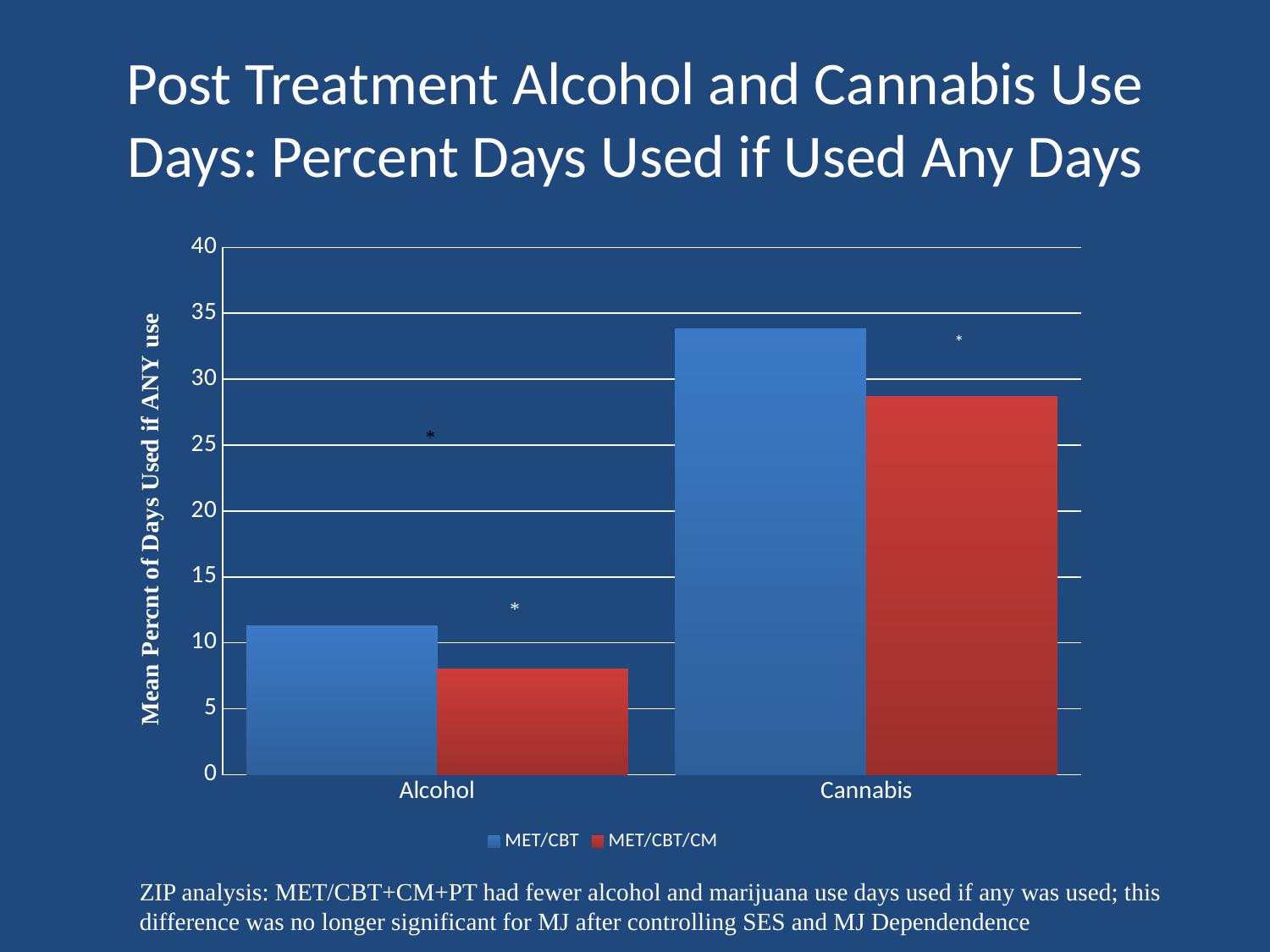
How many series does the legend list? 2 What is the label of the y axis? Mean Percnt of Days Used if ANY use Which category has the highest bar for MET/CBT? Cannabis For Cannabis, which series has the larger value, MET/CBT or MET/CBT/CM? MET/CBT How many categories are shown on the x axis? 2 What kind of chart is shown on the slide? bar chart Is the value for MET/CBT in the Cannabis category greater or less than 30? greater For Alcohol, which series has the larger value, MET/CBT or MET/CBT/CM? MET/CBT Is the value for MET/CBT/CM in the Cannabis category greater or less than 25? greater Is the value for MET/CBT/CM in the Alcohol category greater or less than 10? less Which category has the lowest bar for MET/CBT/CM? Alcohol Which series is shown in red? MET/CBT/CM